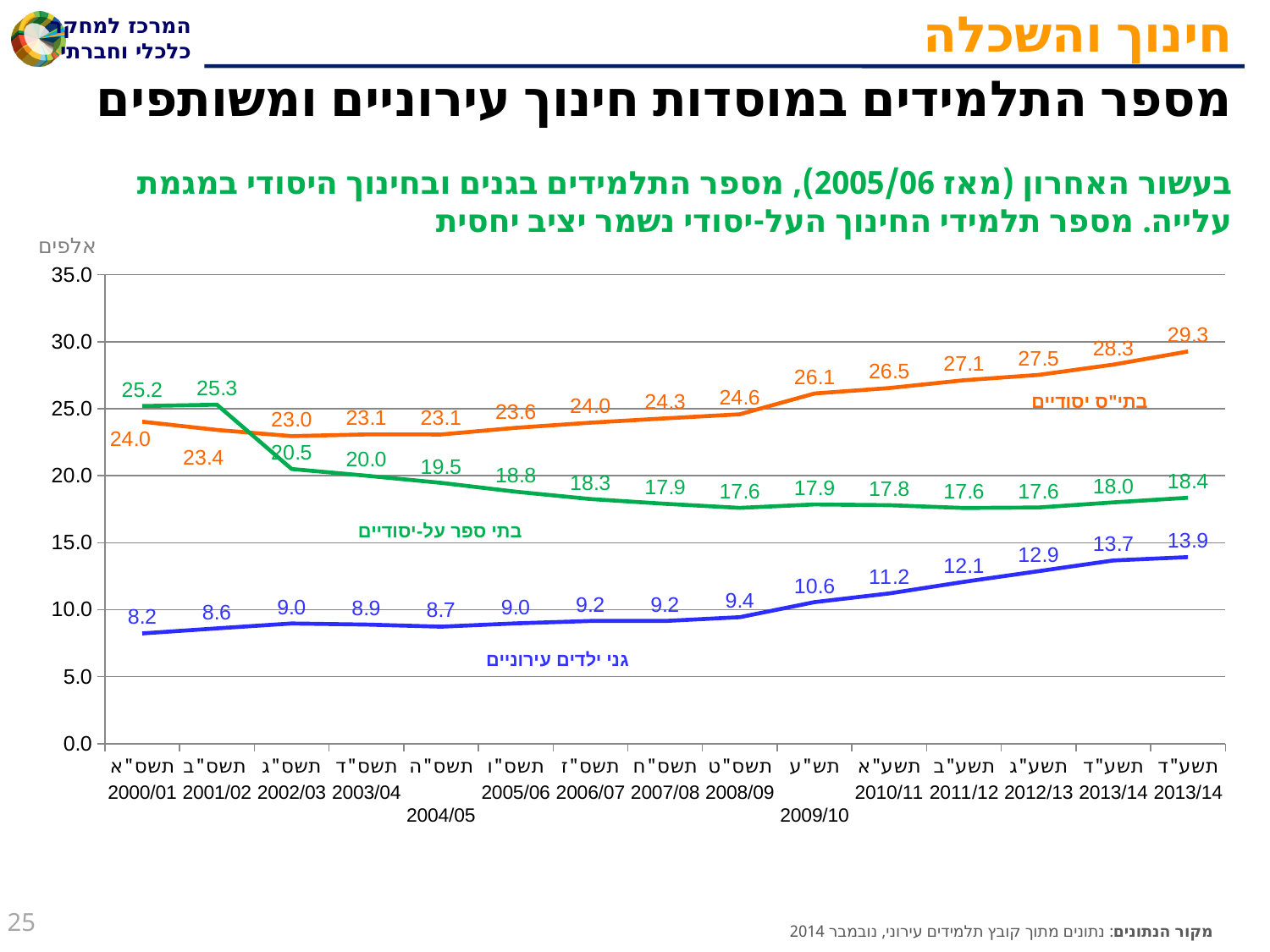
What unit label is shown at the top of the y-axis? אלפים What kind of chart is shown on the slide? line chart How many data series are plotted on the chart? 3 What is the difference between the בתי"ס יסודיים value and the גני ילדים עירוניים value for 2012/13? 14.6 What is the value of the בתי"ס יסודיים (orange) series for 2009/10? 26.1 What is the highest value shown for the בתי"ס יסודיים (orange) series? 29.3 Is the value of the גני ילדים עירוניים series for 2011/12 greater or less than 10.0? greater Does the גני ילדים עירוניים (blue) series generally rise or fall from 2008/09 to the end of the chart? rise What is the lowest value shown for the בתי ספר על-יסודיים (green) series? 17.6 In 2001/02, which series has the larger value: בתי"ס יסודיים or בתי ספר על-יסודיים? בתי ספר על-יסודיים What is the value of the גני ילדים עירוניים (blue) series for 2000/01? 8.2 What is the value of the בתי ספר על-יסודיים (green) series for 2004/05? 19.5